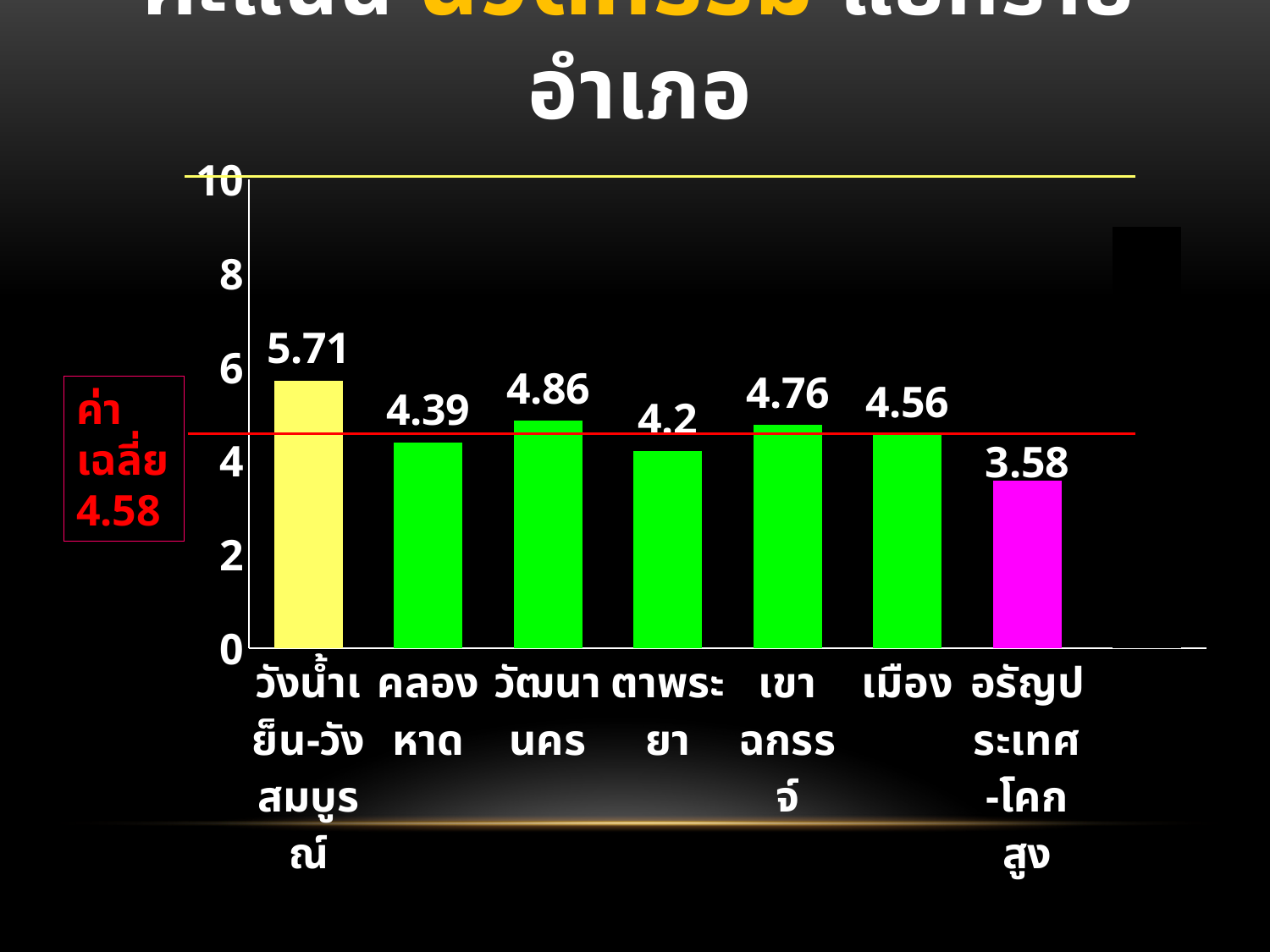
What is the difference between the values for วังน้ำเย็น-วังสมบูรณ์ and อรัญประเทศ-โคกสูง? 2.13 What is the value for ตาพระยา? 4.2 What average value (ค่าเฉลี่ย) is marked by the red line on the chart? 4.58 Which district has the lowest value? อรัญประเทศ-โคกสูง Is the value for คลองหาด greater or less than 6? less What is the value for วัฒนานคร? 4.86 What kind of chart is shown on the slide? bar chart How many districts are shown in the chart? 7 What is the value for อรัญประเทศ-โคกสูง? 3.58 What is the difference between the values for วัฒนานคร and คลองหาด? 0.47 Which district has the highest value? วังน้ำเย็น-วังสมบูรณ์ Which is larger, the value for เขาฉกรรจ์ or the value for เมือง? เขาฉกรรจ์